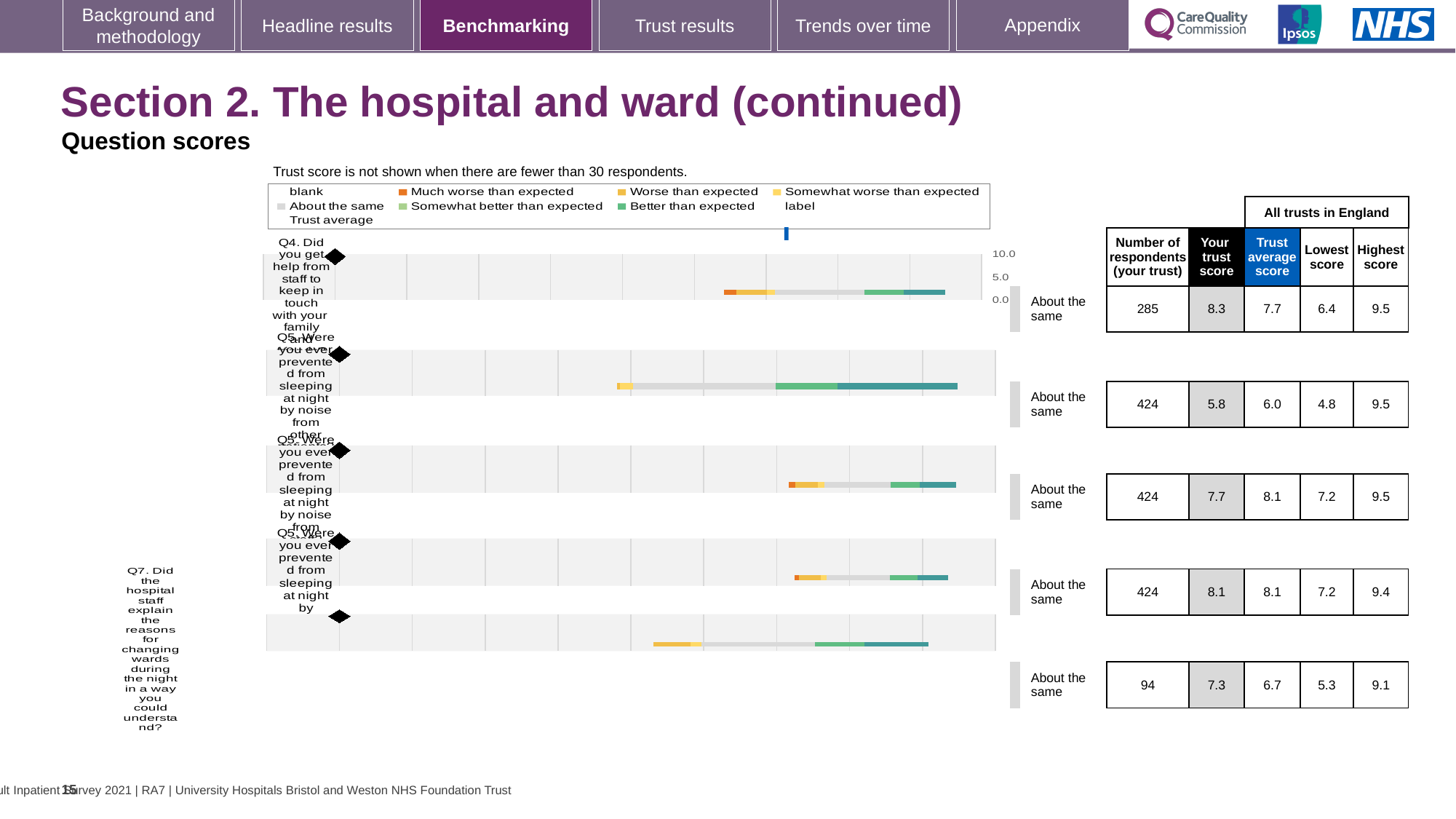
What is the 'Your trust score' for Q7 (the last row of the chart), about staff explaining reasons for changing wards during the night? 7.3 How many respondents from your trust answered Q4 (the first row of the chart)? 285 Which row of the chart has the lowest 'Your trust score'? The second row (5.8) For Q7 (the last row), which is larger: your trust score or the trust average score? Your trust score What kind of chart is used to show the question scores? Bar chart What is the 'Your trust score' for Q4 (the first row of the chart), about getting help from staff to keep in touch with family and friends? 8.3 What is the trust average score for Q4 (the first row of the chart)? 7.7 How many question rows are plotted in the chart? 5 What benchmark category is shown next to every question row in the chart? About the same What is the lowest score among all trusts in England for Q7 (the last row of the chart)? 5.3 By how much does your trust score for Q4 (the first row) exceed the trust average score for that question? 0.6 How many respondents from your trust answered Q7 (the last row of the chart)? 94